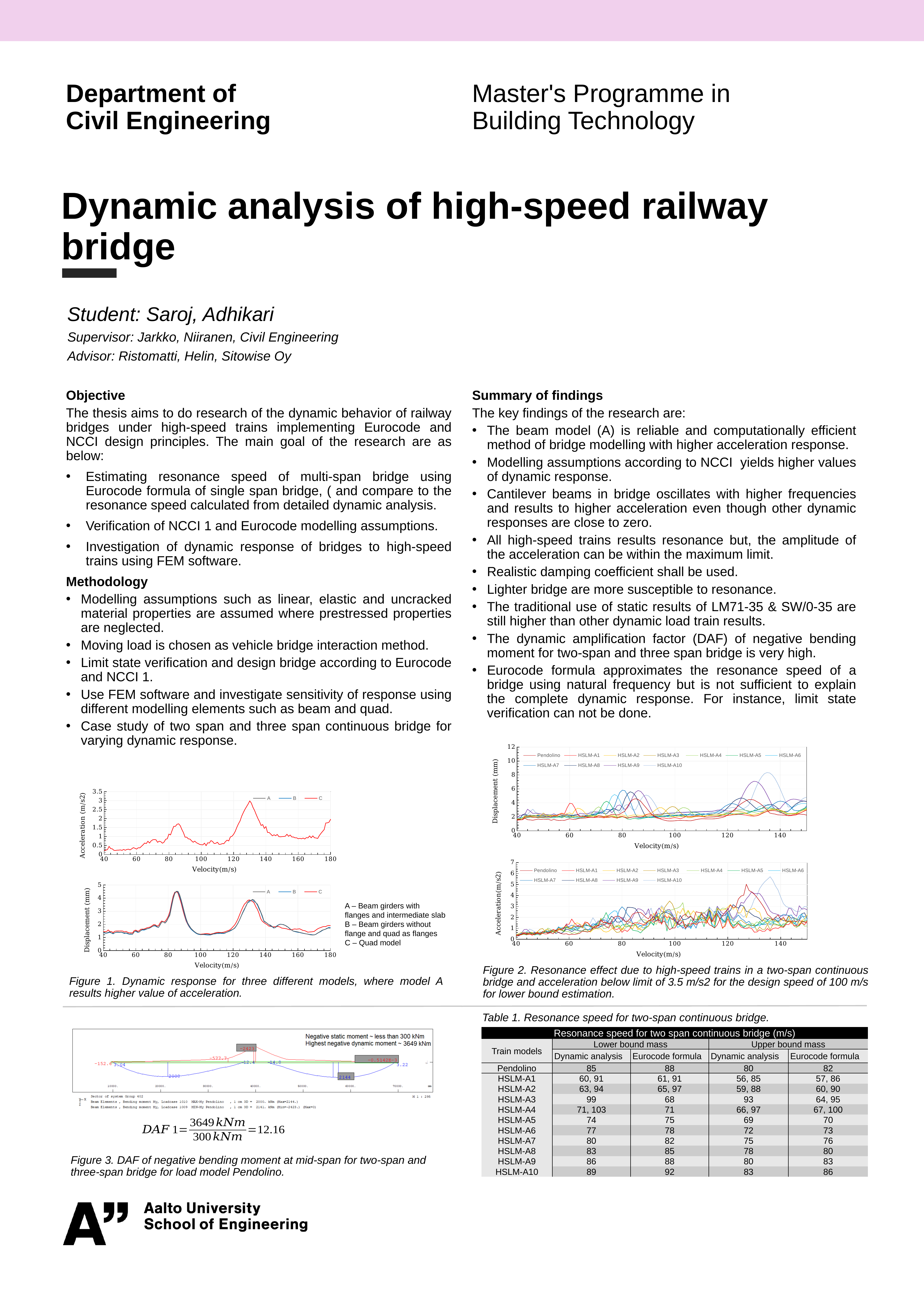
In the top chart of Figure 1, is the peak acceleration of series C near 130 m/s greater or less than 2? greater In the bottom chart of Figure 1 (Displacement vs Velocity), is the peak displacement near 85 m/s greater or less than 4? greater In the top chart of Figure 1, is the acceleration of series C higher at 130 m/s or at 85 m/s? 130 m/s How many series does the legend of the top chart in Figure 1 list? 3 How many series does the legend of the top chart in Figure 2 (Displacement vs Velocity) list? 11 What kind of chart is the top chart of Figure 1 (Acceleration vs Velocity)? Line chart In the top chart of Figure 2, what is the label of the x axis? Velocity(m/s) In the top chart of Figure 2 (Displacement vs Velocity), is the highest displacement reached by any series greater or less than 6? greater In the top chart of Figure 1, does the acceleration of series C rise or fall between 100 m/s and 130 m/s? rise In the bottom chart of Figure 1, is the displacement peak near 85 m/s higher or lower than the peak near 130 m/s? higher In the top chart of Figure 1, what is the label of the y axis? Acceleration (m/s2)